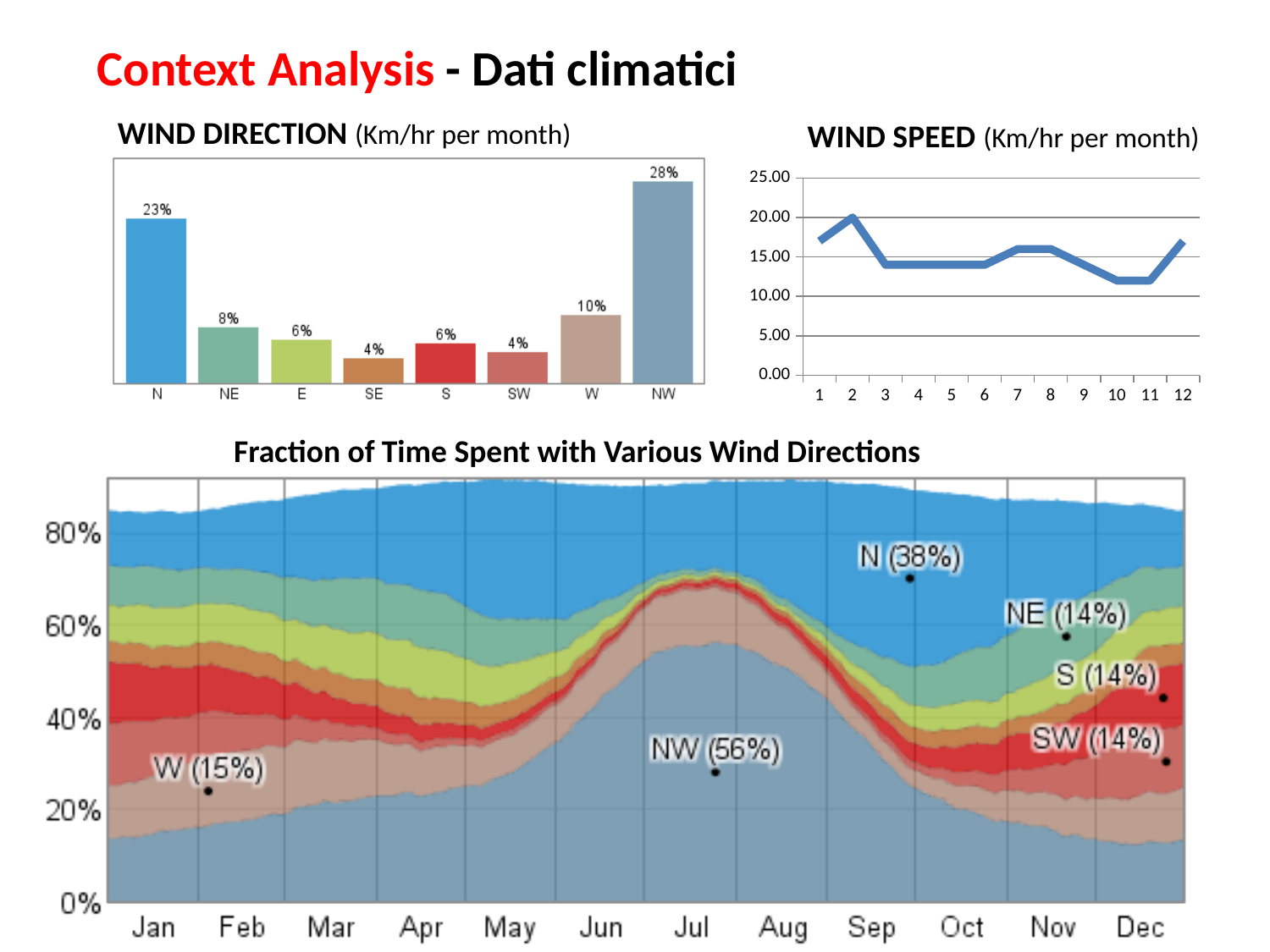
How many directions are shown in the WIND DIRECTION chart? 8 In the WIND DIRECTION chart, what is the value for W? 10% In the WIND SPEED chart, is the value for month 2 greater or less than 15.00? greater In the WIND SPEED chart, is the value for month 10 greater or less than 15.00? less In the WIND DIRECTION chart, which is larger, the value for NE or the value for W? W In the WIND DIRECTION chart, what is the difference between the values for NW and N? 5% What kind of chart is the WIND DIRECTION chart? bar chart What kind of chart is the WIND SPEED chart? line chart In the WIND DIRECTION chart, what is the value for NW? 28% In the Fraction of Time Spent with Various Wind Directions chart, what percentage is labelled for NW? 56% In the WIND DIRECTION chart, which direction has the highest value? NW In the WIND DIRECTION chart, what is the value for N? 23%